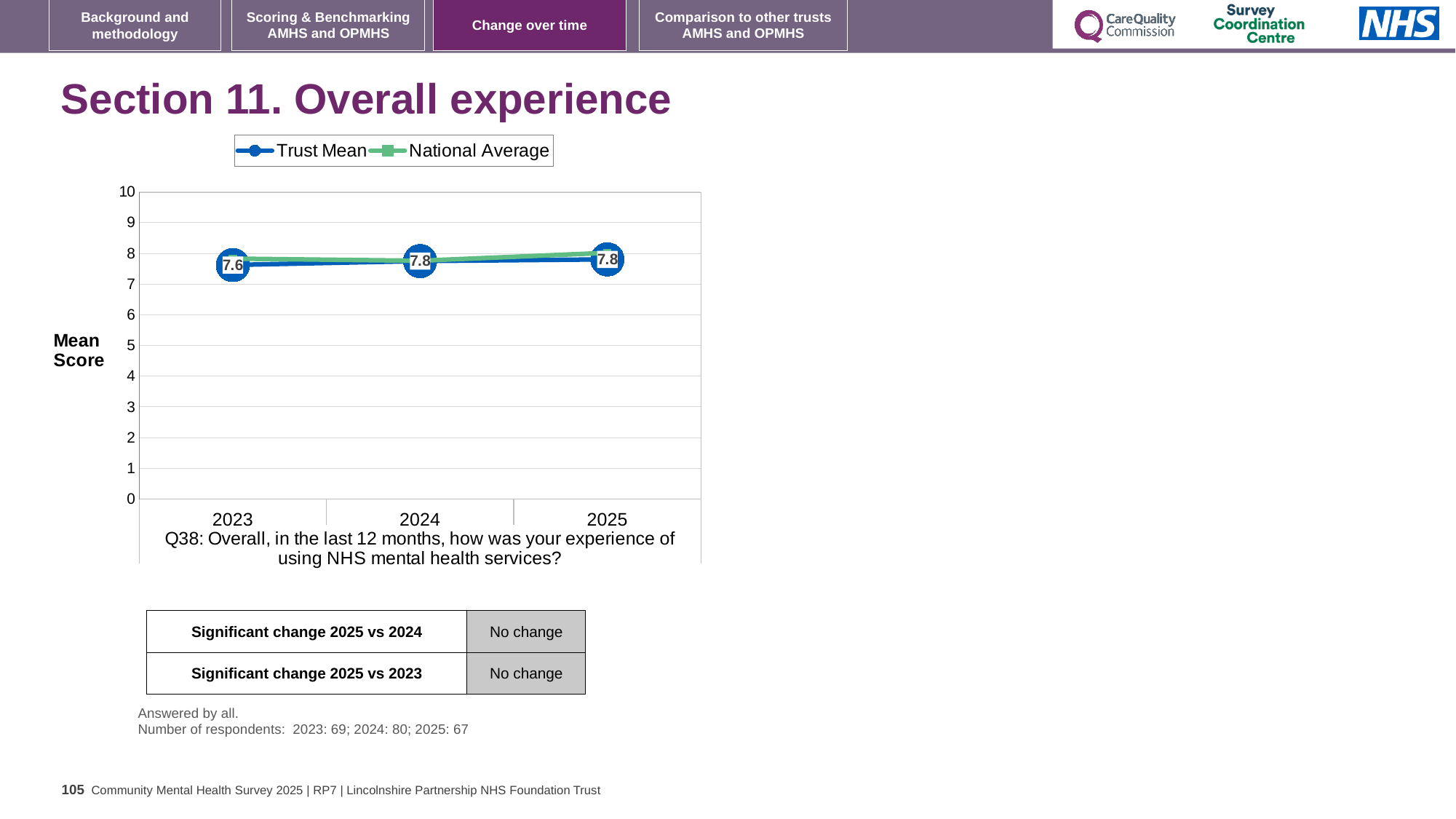
What is the Trust Mean for 2023? 7.6 How many series does the legend list? 2 What is the label on the y axis of the chart? Mean Score What kind of chart is shown on the slide? line chart What is the difference between the Trust Mean in 2025 and in 2023? 0.2 In which year is the Trust Mean lowest? 2023 Which is larger, the Trust Mean in 2023 or in 2024? 2024 How many years are plotted on the x axis? 3 Is the National Average value for 2025 greater or less than 7? greater What is the Trust Mean for 2025? 7.8 What is the Trust Mean for 2024? 7.8 Does the Trust Mean rise or fall from 2023 to 2025? rise